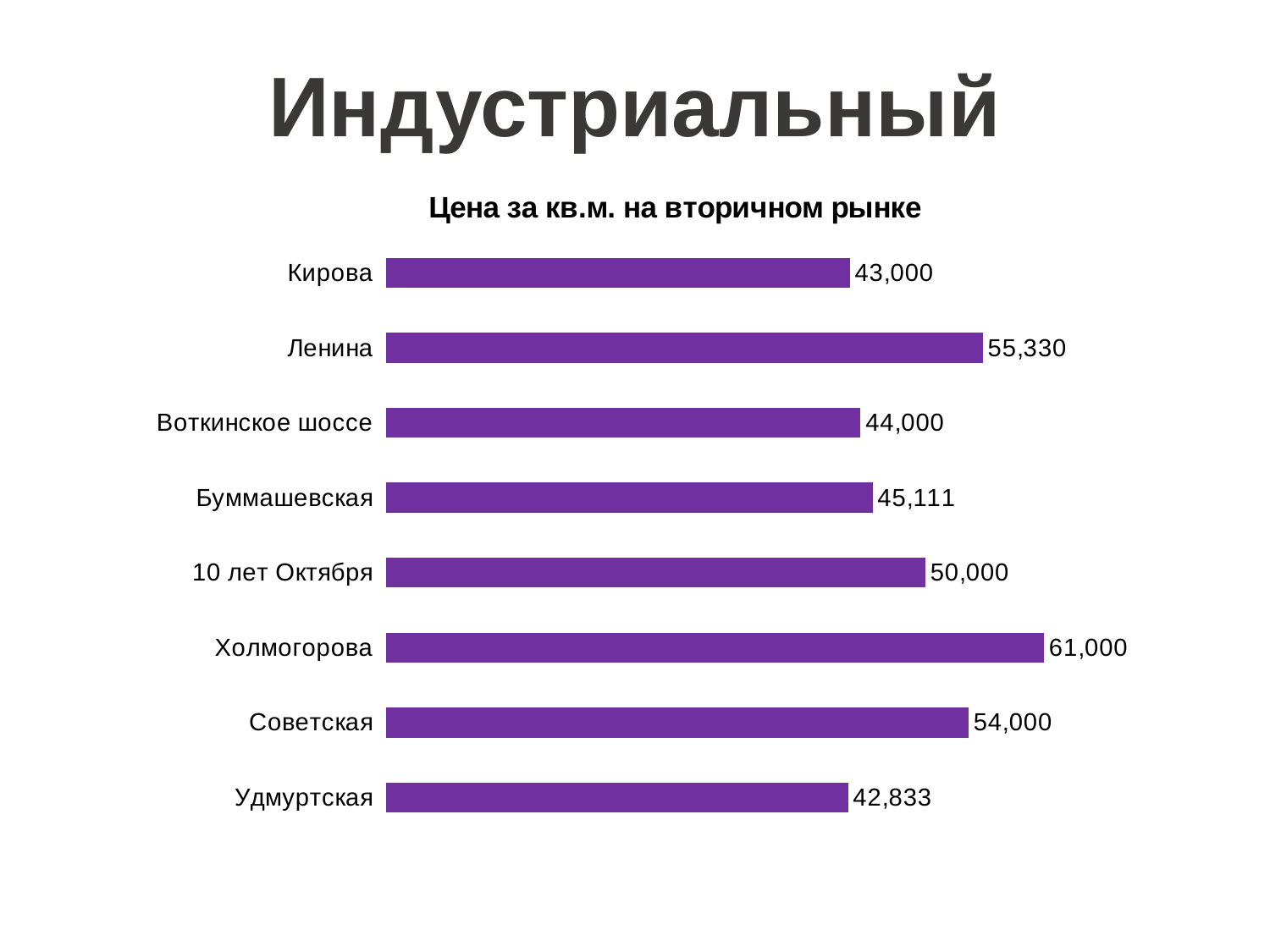
What is the value for Ленина? 55,330 What kind of chart is shown on the slide? Bar chart What is the value for Удмуртская? 42,833 What is the difference between the values for Советская and 10 лет Октября? 4,000 What is the value for Буммашевская? 45,111 Which is larger, the value for Ленина or the value for Советская? Ленина What is the title of the chart? Цена за кв.м. на вторичном рынке What is the value for Холмогорова? 61,000 Which street has the highest price per square metre? Холмогорова What is the difference between the values for Холмогорова and Кирова? 18,000 How many streets are shown in the chart? 8 Which street has the lowest price per square metre? Удмуртская